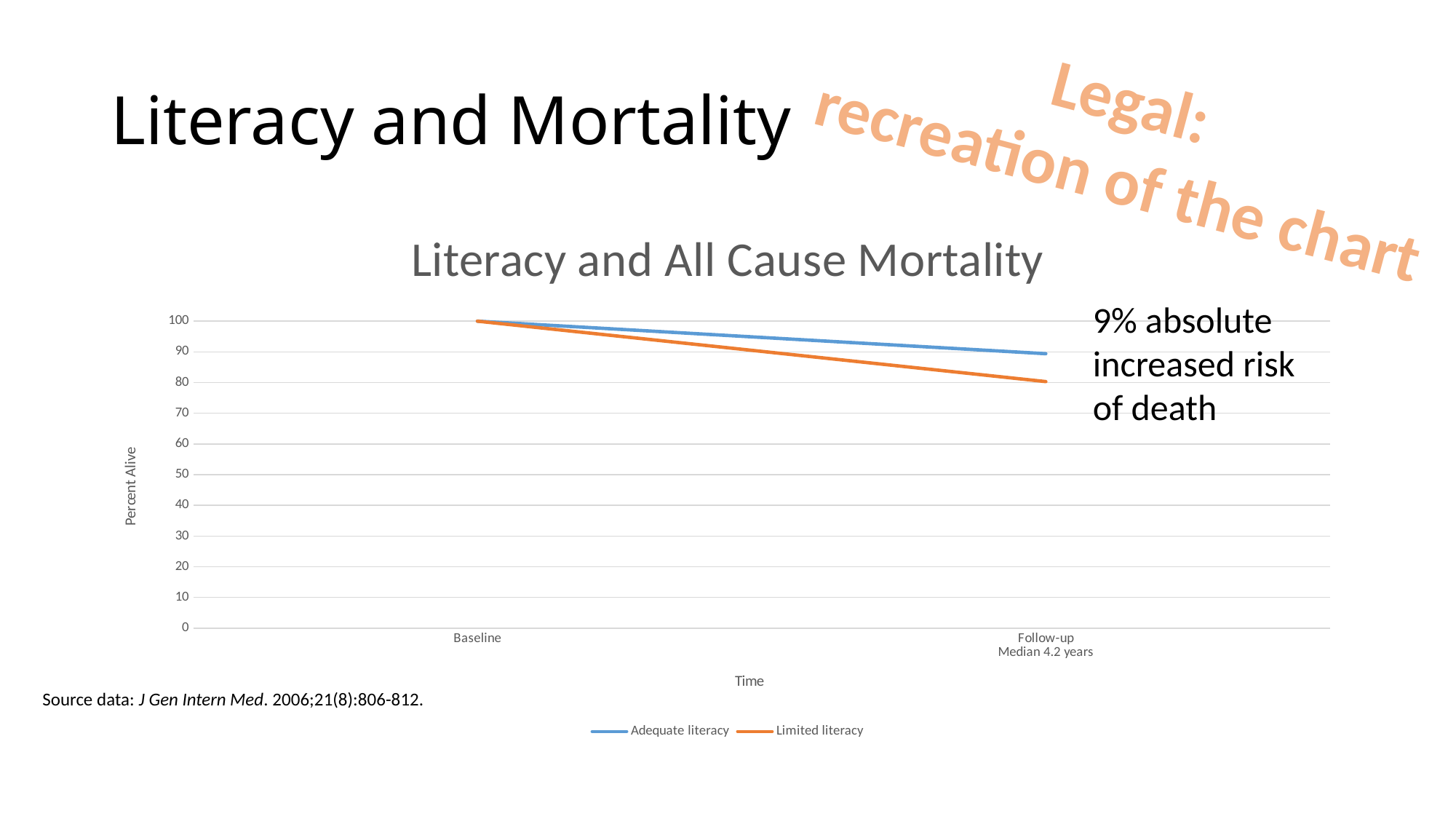
How many time points are plotted along the x axis? 2 What is the title of the chart? Literacy and All Cause Mortality What is the Percent Alive value for Limited literacy at Baseline? 100 What is the Percent Alive value for Adequate literacy at Baseline? 100 What kind of chart is shown on the slide? Line chart What is the label on the vertical axis of the chart? Percent Alive Is the Percent Alive value for Adequate literacy at Follow-up greater or less than 80? greater How many series does the chart legend list? 2 Is the Percent Alive value for Limited literacy at Follow-up greater or less than 90? less At Follow-up, which series has the higher Percent Alive: Adequate literacy or Limited literacy? Adequate literacy Is the Percent Alive value for Adequate literacy at Follow-up greater or less than 100? less Do the Percent Alive values rise or fall from Baseline to Follow-up? fall